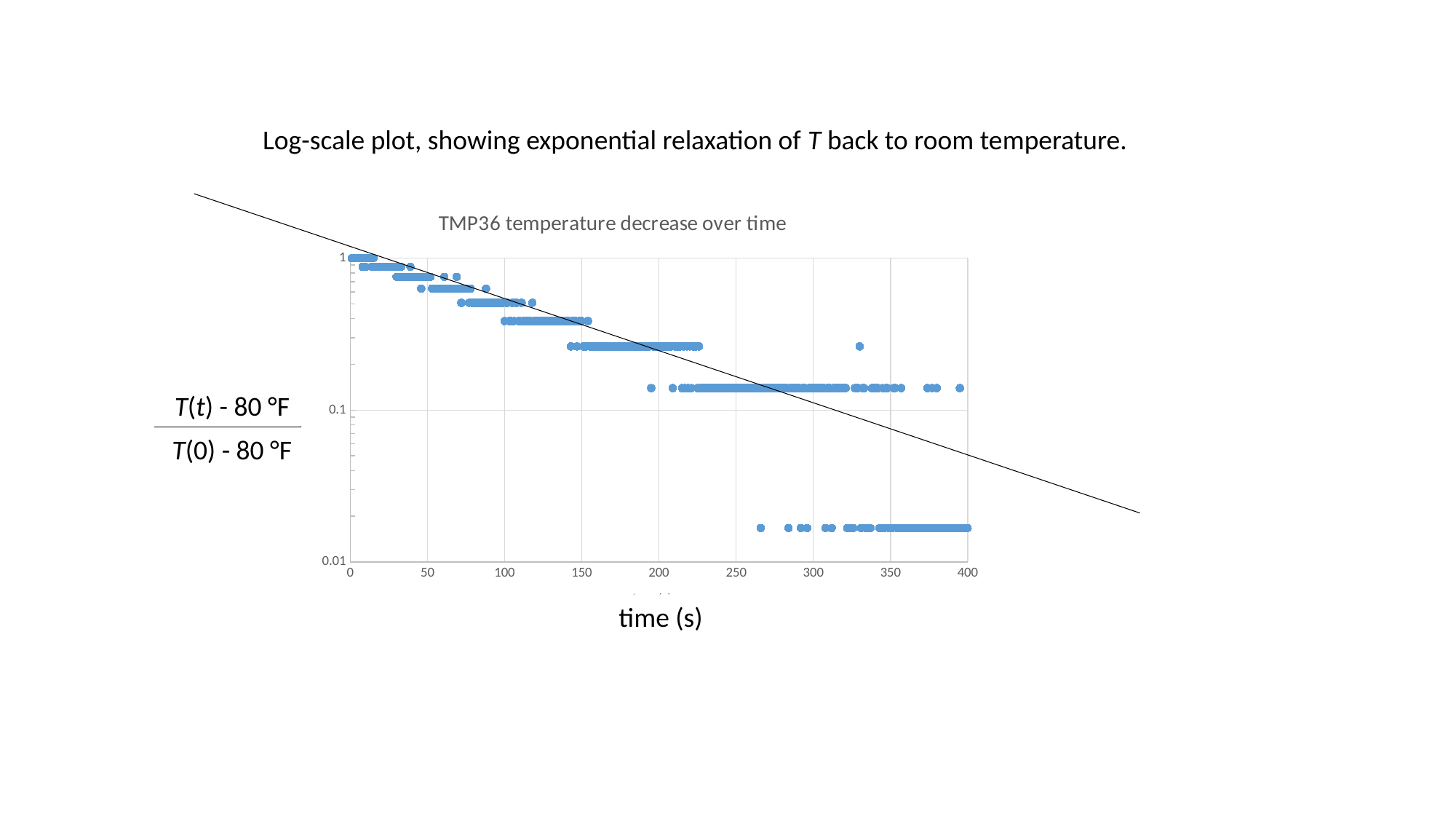
Is the plotted value at time 0 s greater or less than 0.5? greater Do the plotted values rise or fall as time increases along the x axis? fall Is the plotted value at time 50 s greater or less than 0.1? greater Are the plotted values at time 150 s greater or less than 1? less What kind of chart is shown on the slide? scatter plot What is the largest value shown on the x axis? 400 What is the title of the chart? TMP36 temperature decrease over time What is the label of the x axis? time (s)